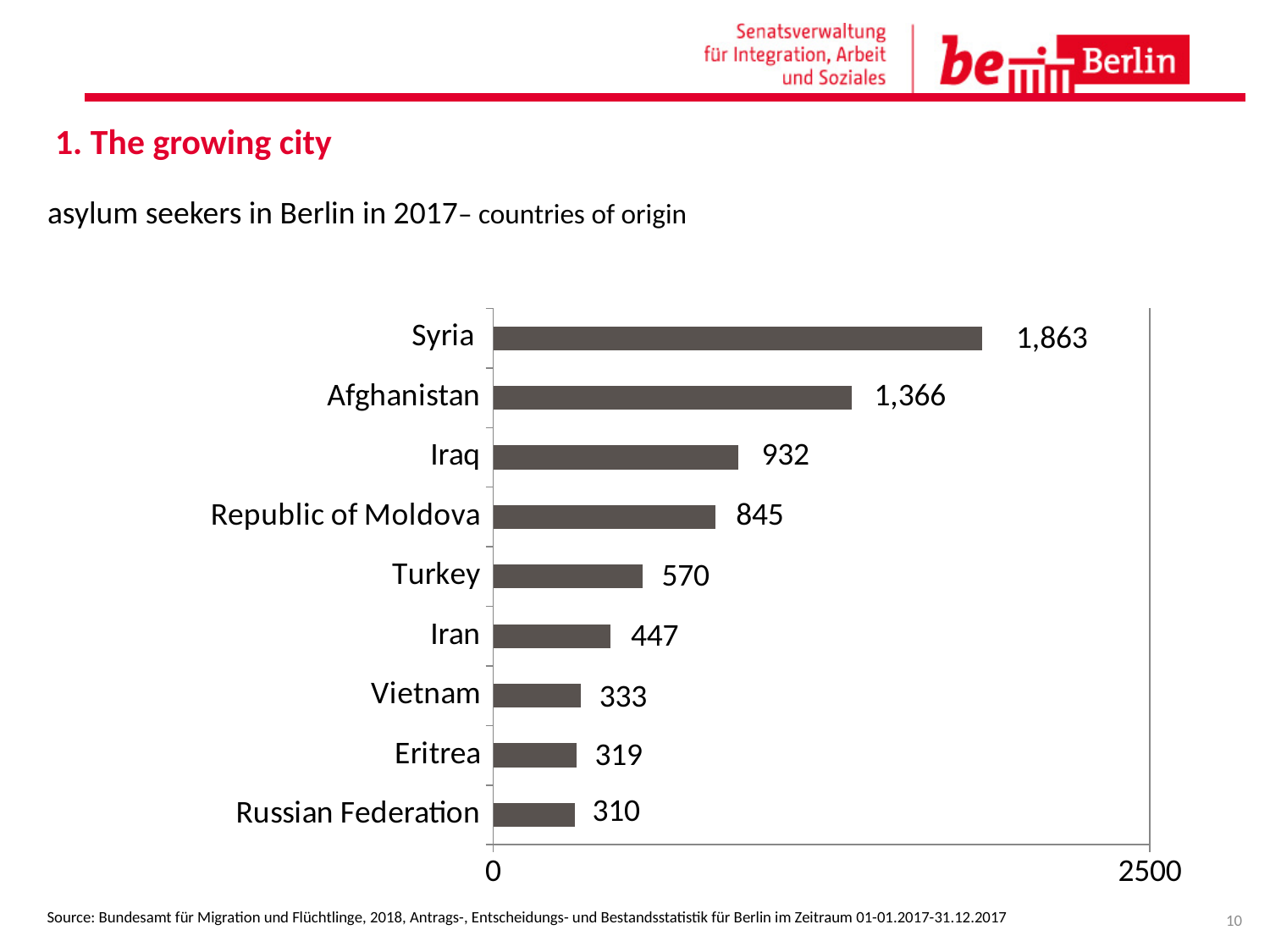
What is the value for Republic of Moldova? 845 Which is larger, the value for Iran or the value for Eritrea? Iran What is the difference between the values for Syria and Afghanistan? 497 Which country has the lowest value? Russian Federation What is the value for Vietnam? 333 How many countries are shown in the chart? 9 What is the difference between the values for Iraq and Turkey? 362 Which country has the highest value? Syria What is the maximum value shown on the horizontal axis? 2500 What kind of chart is shown on the slide? bar chart What is the subtitle describing the chart's subject? asylum seekers in Berlin in 2017 – countries of origin What is the value for Syria? 1,863